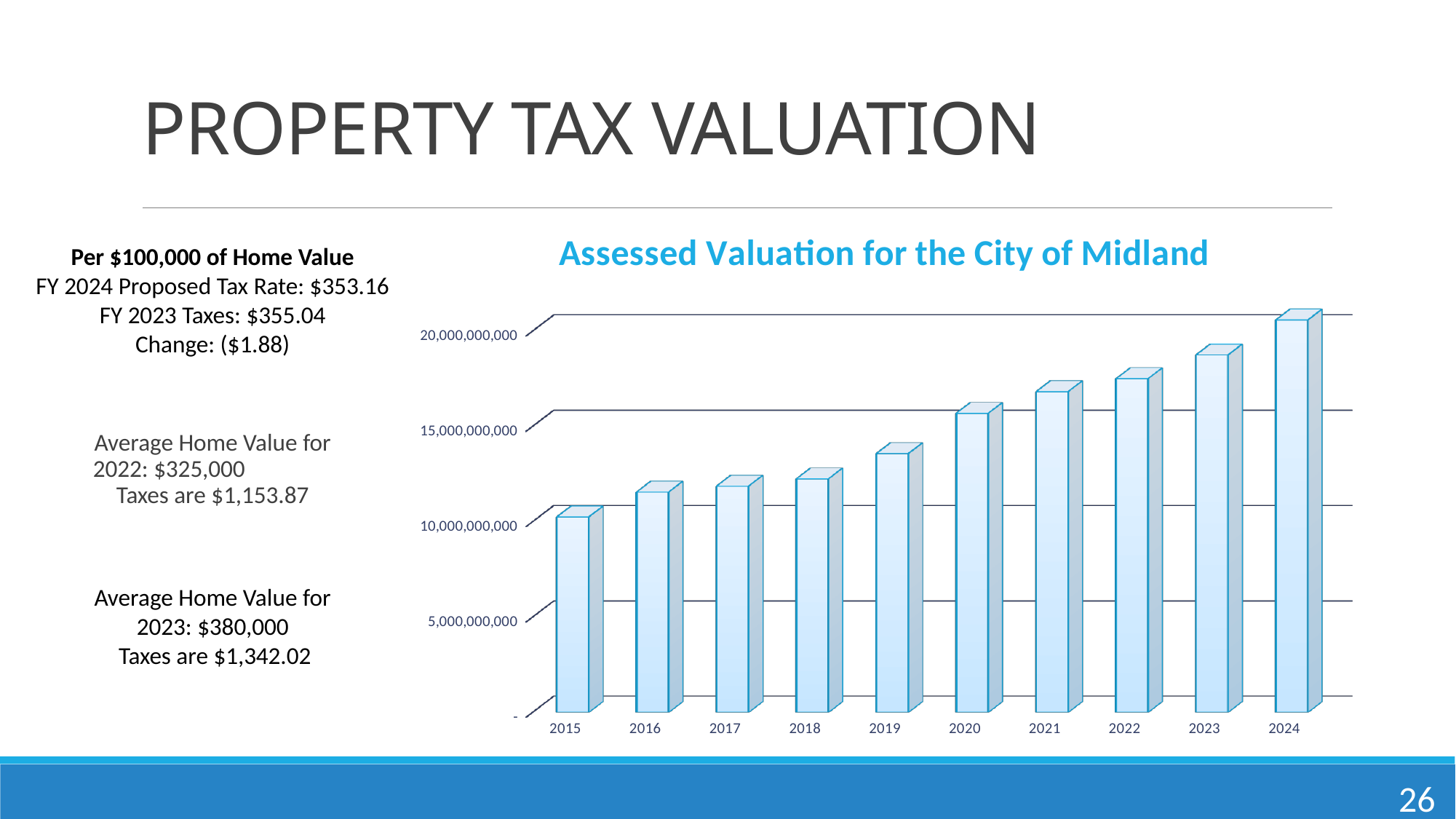
Is the assessed valuation for 2019 greater or less than 15,000,000,000? less Which year has the highest assessed valuation? 2024 How many years are shown on the x axis of the chart? 10 Which year has the lowest assessed valuation? 2015 Is the assessed valuation for 2022 greater or less than 15,000,000,000? greater What kind of chart is shown on the slide? bar chart Is the assessed valuation for 2016 greater or less than 10,000,000,000? greater Do the assessed valuation values rise or fall from 2015 to 2024? rise Which year has a larger assessed valuation, 2023 or 2021? 2023 Which year has a larger assessed valuation, 2017 or 2019? 2019 What is the title of the chart? Assessed Valuation for the City of Midland